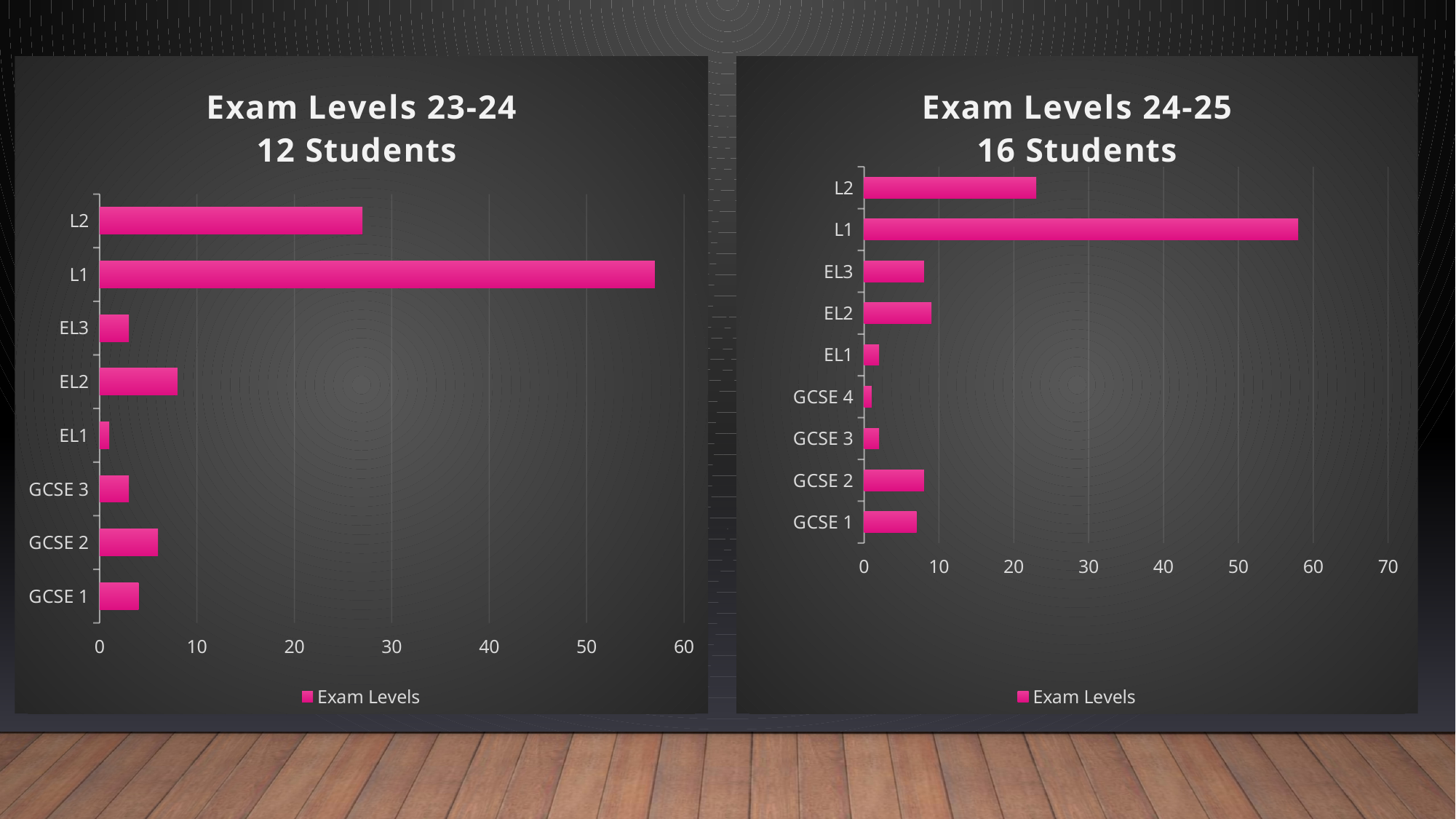
In the 'Exam Levels 23-24 12 Students' chart, which is larger, EL2 or GCSE 1? EL2 In the 'Exam Levels 24-25 16 Students' chart, is the value for L2 greater or less than 30? less In the 'Exam Levels 24-25 16 Students' chart, which exam level has the lowest value? GCSE 4 How many series does the legend of the 'Exam Levels 24-25 16 Students' chart list? 1 In the 'Exam Levels 23-24 12 Students' chart, which exam level has the highest value? L1 How many exam level categories are shown in the 'Exam Levels 23-24 12 Students' chart? 8 In the 'Exam Levels 23-24 12 Students' chart, is the value for L2 greater or less than 20? greater How many exam level categories are shown in the 'Exam Levels 24-25 16 Students' chart? 9 In the 'Exam Levels 24-25 16 Students' chart, which exam level has the highest value? L1 In the 'Exam Levels 23-24 12 Students' chart, which exam level has the lowest value? EL1 What type of chart is the 'Exam Levels 23-24 12 Students' chart on the left? bar chart In the 'Exam Levels 23-24 12 Students' chart, is the value for L1 greater or less than 50? greater